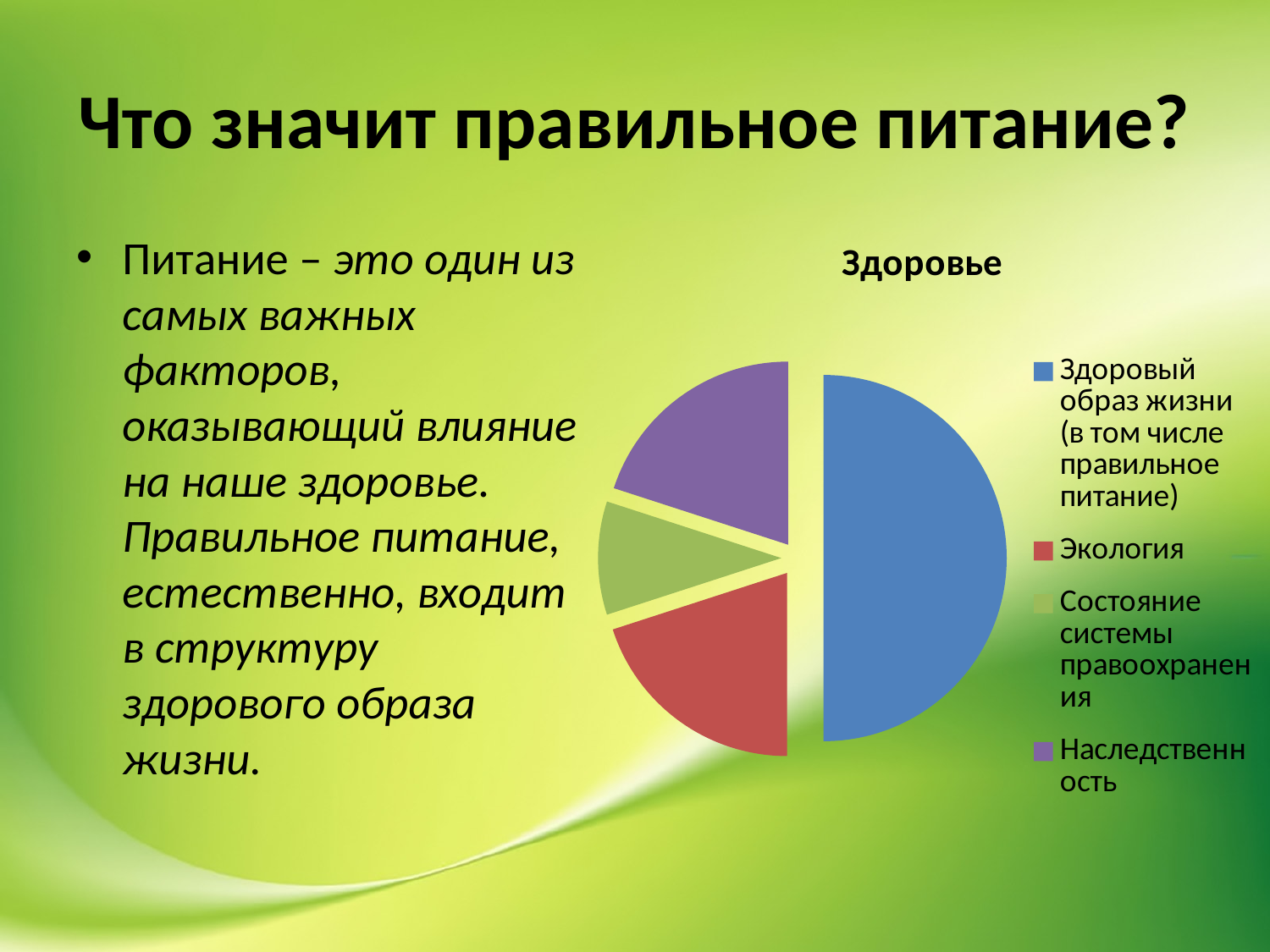
Which slice is larger: Экология or Состояние системы правоохранения? Экология Which category has the smallest slice in the pie chart? Состояние системы правоохранения How many slices does the pie chart have? 4 Which category has the largest slice in the pie chart? Здоровый образ жизни (в том числе правильное питание) What is the title of the pie chart? Здоровье Which slice is larger: Наследственность or Состояние системы правоохранения? Наследственность What kind of chart is shown on the slide? pie chart What colour is the slice for Наследственность? purple Which slice is larger: Здоровый образ жизни or Экология? Здоровый образ жизни How many entries does the legend of the pie chart list? 4